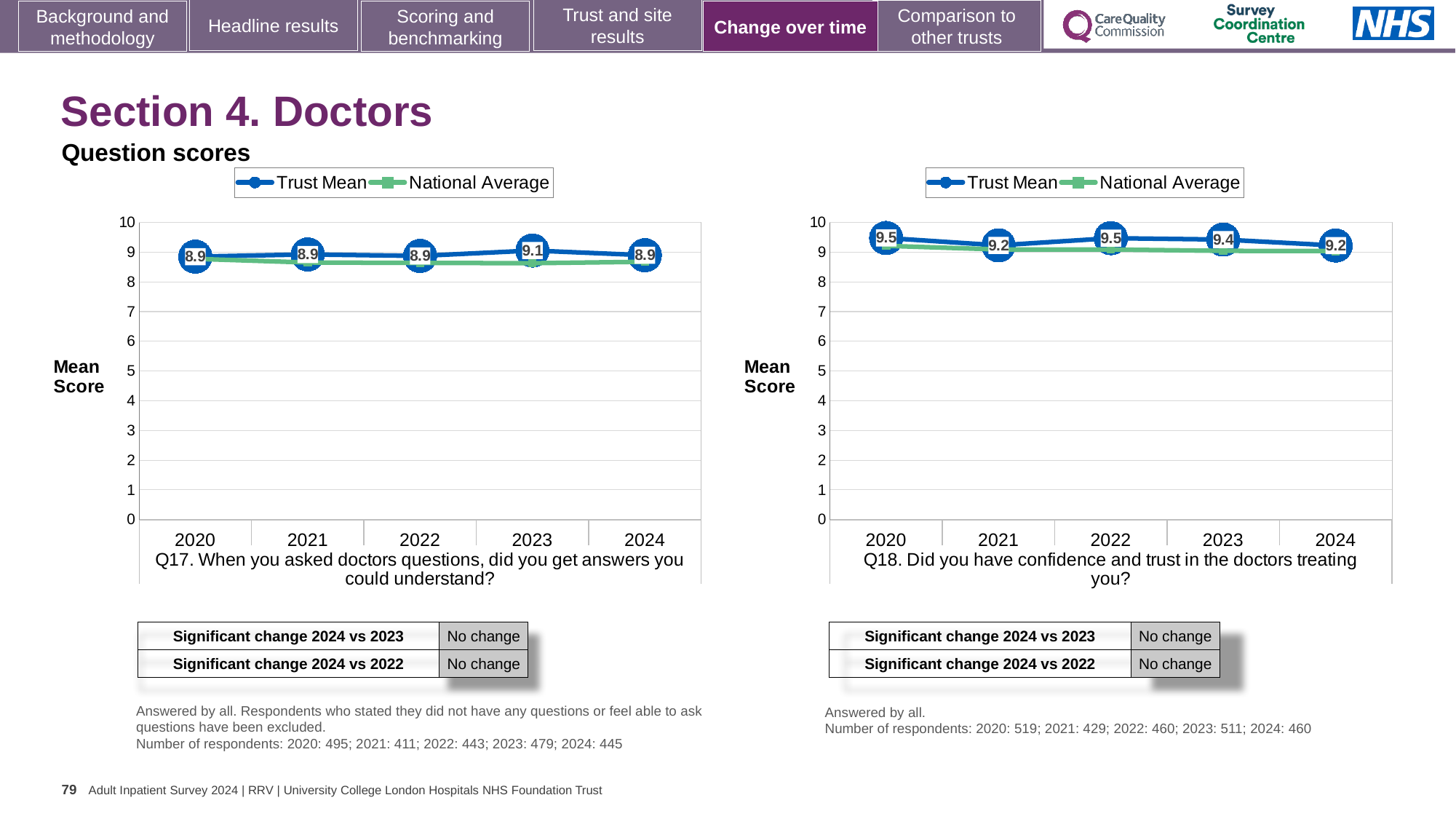
How many years are plotted on the Q18 chart (right)? 5 How many series does the legend of the Q17 chart (left) list? 2 On the Q17 chart (left), what is the Trust Mean score for 2023? 9.1 On the Q17 chart (left), is the National Average value for 2020 greater or less than 8? greater On the Q17 chart (left), what is the difference between the Trust Mean scores for 2023 and 2024? 0.2 On the Q18 chart (right), what is the Trust Mean score for 2021? 9.2 On the Q18 chart (right), what is the difference between the Trust Mean scores for 2020 and 2021? 0.3 On the Q18 chart (right), which is larger, the Trust Mean score for 2022 or for 2023? 2022 What are the two series named in the legend of the Q17 chart (left)? Trust Mean and National Average On the Q17 chart (left), which year has the highest Trust Mean score? 2023 What type of chart is the Q18 chart (right)? Line chart On the Q18 chart (right), what is the Trust Mean score for 2020? 9.5